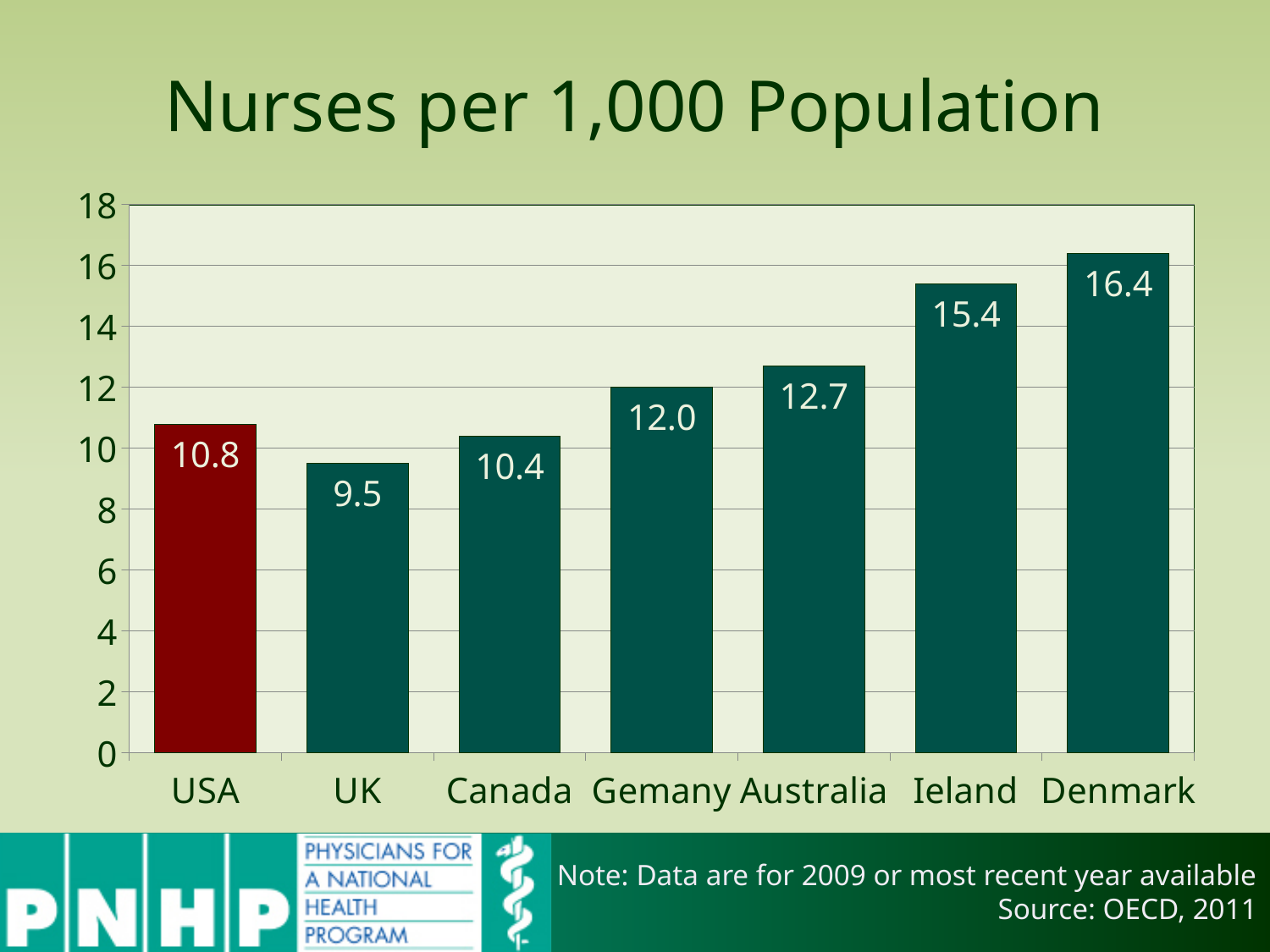
Which bar is coloured differently from the others? USA Which country has the lowest number of nurses per 1,000 population? UK What is the value for the USA? 10.8 Is the value for Ieland greater or less than 14? greater What is the difference between the values for Denmark and the USA? 5.6 What kind of chart is shown on the slide? bar chart What is the value for Australia? 12.7 Which is larger, the value for the USA or the value for Canada? USA What is the value for Canada? 10.4 How many countries are shown in the chart? 7 Which country has the highest number of nurses per 1,000 population? Denmark What is the difference between the values for Ieland and Gemany? 3.4